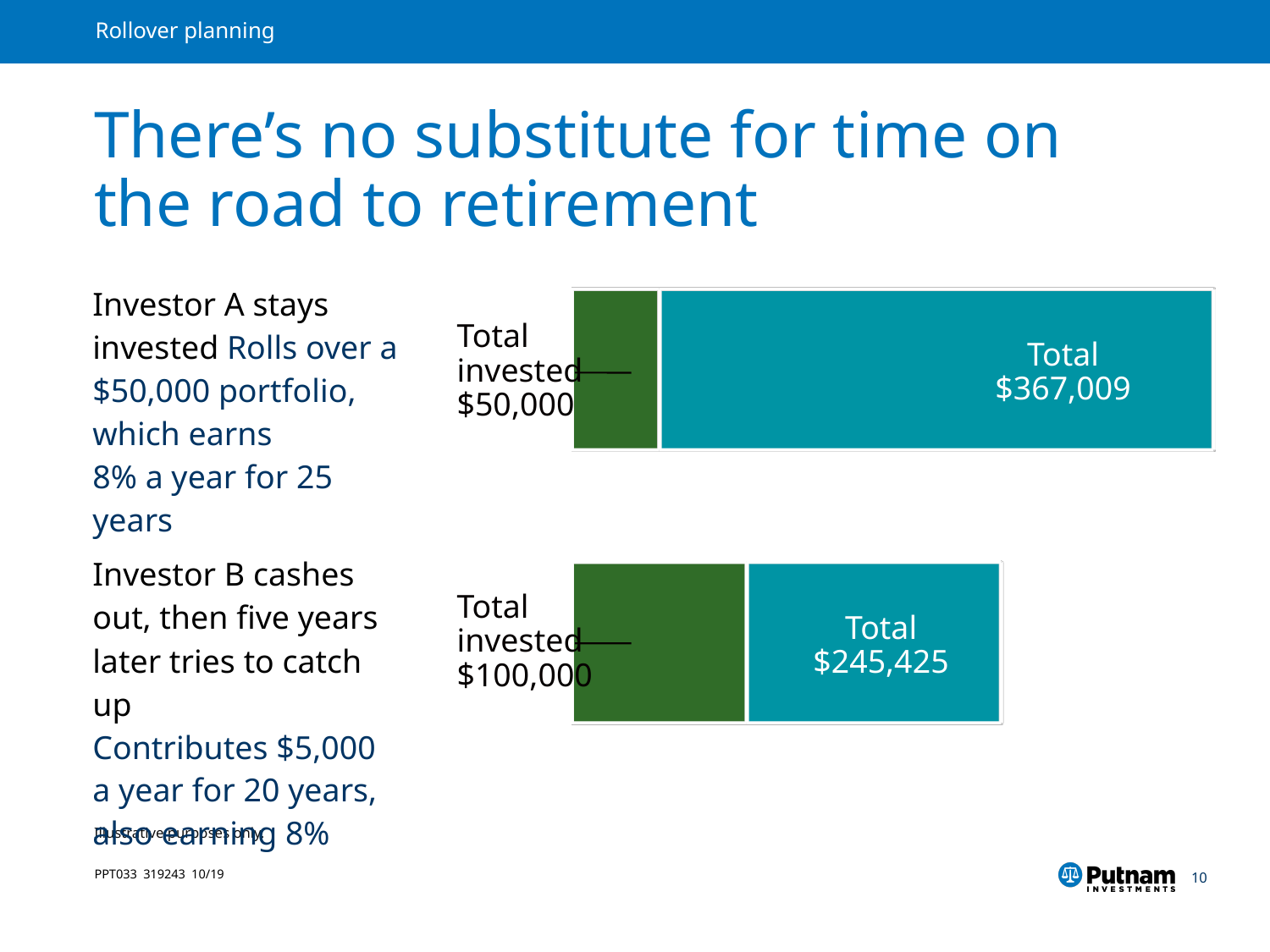
In the bottom chart (Investor B), what total value is labeled on the teal bar? $245,425 In the top chart, what colour is the segment representing the total invested amount? Green What is the difference between the total invested in the bottom chart and the total invested in the top chart? $50,000 In the bottom chart, what colour is the segment labeled with the total of $245,425? Teal What kind of chart is used to show the investor totals on this slide? Bar chart Which investor's chart shows the larger total invested amount, Investor A or Investor B? Investor B In the top chart (Investor A), what total value is labeled on the teal bar? $367,009 Which investor's chart shows the larger total, Investor A or Investor B? Investor A In the top chart (Investor A), what is the total invested amount shown? $50,000 How many bar charts are shown on the slide? 2 What is the difference between the total in the top chart ($367,009) and the total in the bottom chart ($245,425)? $121,584 In the bottom chart (Investor B), what is the total invested amount shown? $100,000